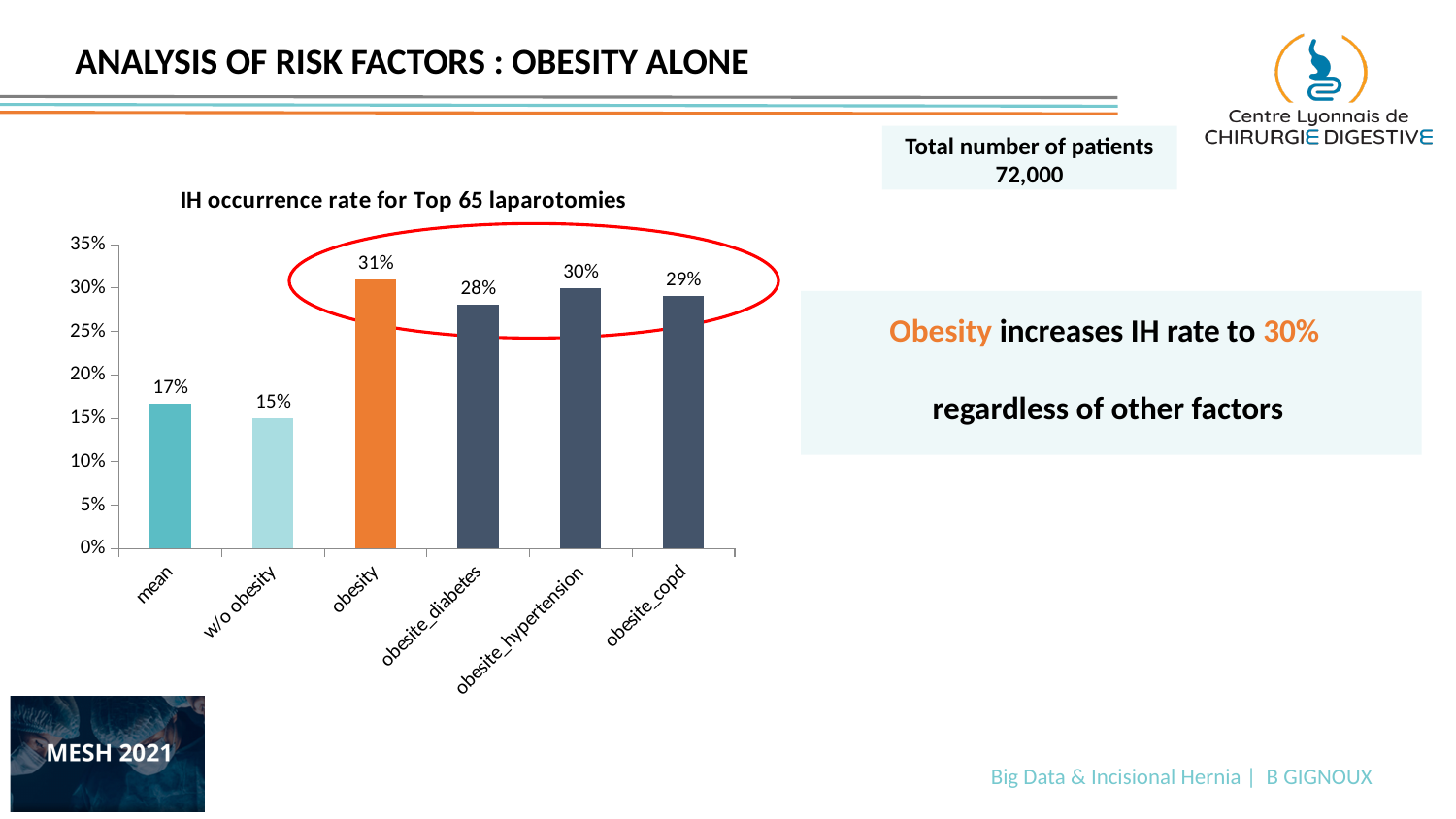
Which category has the highest IH occurrence rate? obesity How many categories are shown on the x axis of the chart? 6 Which category has the lowest IH occurrence rate? w/o obesity What is the IH occurrence rate for the obesity category? 31% What is the IH occurrence rate for obesite_hypertension? 30% What is the IH occurrence rate for the mean category? 17% What is the title of the chart? IH occurrence rate for Top 65 laparotomies Which bar in the chart is coloured orange? obesity What kind of chart is shown on the slide? bar chart Is the value for obesite_diabetes greater or less than 25%? greater Which has a higher IH occurrence rate, obesite_diabetes or obesite_copd? obesite_copd What is the difference in IH occurrence rate between obesity and w/o obesity? 16%